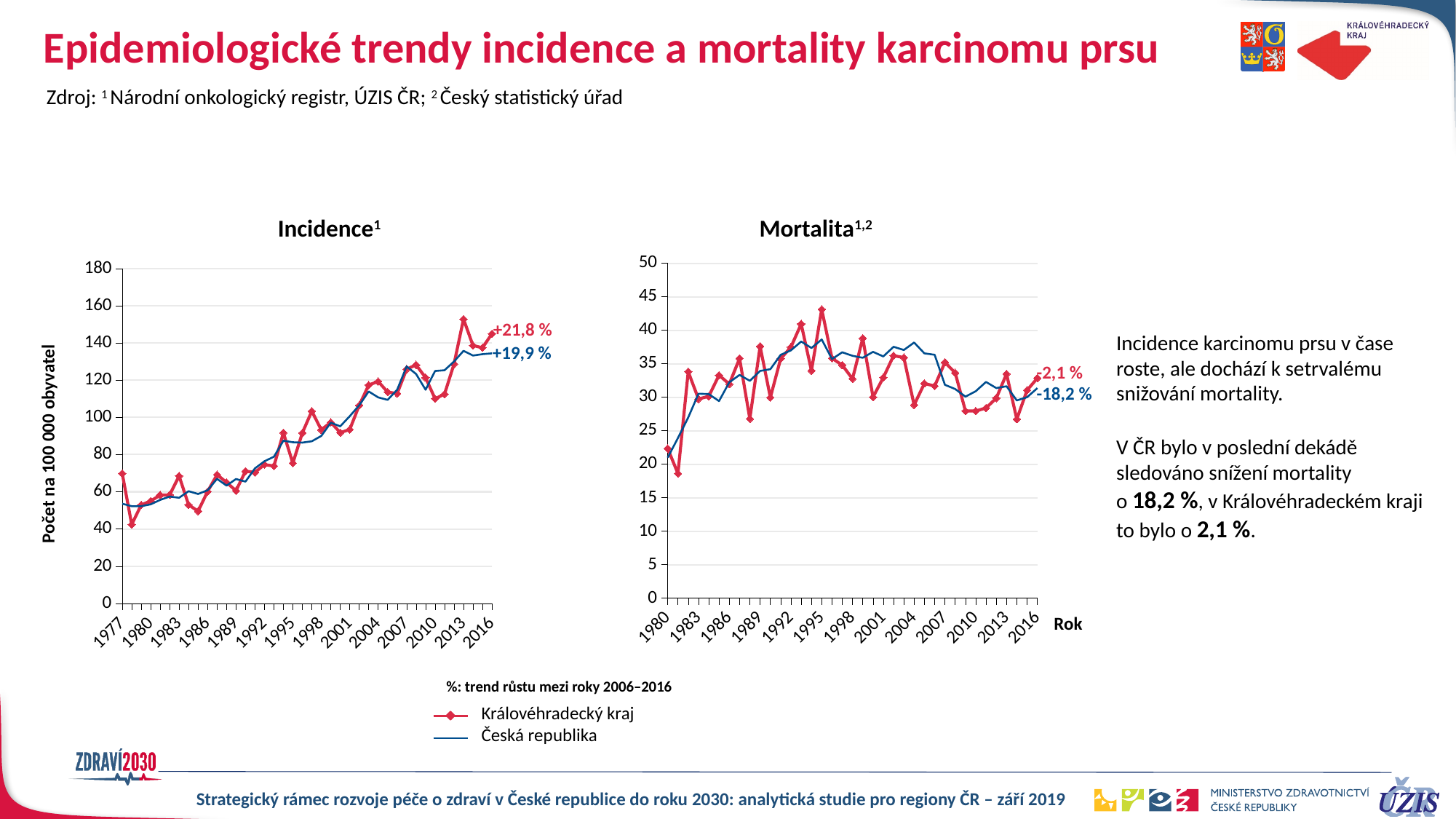
On the Mortalita chart, is the value for Královéhradecký kraj in 1981 greater or less than 20? less On the Mortalita chart, what trend between 2006 and 2016 is printed for Česká republika? -18,2 % On the Mortalita chart, do the values for Česká republika rise or fall from 2006 to 2016? fall What kind of chart is the Incidence chart? line chart On the Incidence chart, is the value for Královéhradecký kraj in 2013 greater or less than 140? greater On the Incidence chart, what growth trend between 2006 and 2016 is printed for Česká republika? +19,9 % Which series is drawn in red on the charts? Královéhradecký kraj On the Incidence chart, do the values for Česká republika generally rise or fall from 1977 to 2016? rise On the Mortalita chart, what trend between 2006 and 2016 is printed for Královéhradecký kraj? -2,1 % How many series does the legend list for the charts? 2 On the Mortalita chart, is the value for Královéhradecký kraj in 1995 greater or less than 40? greater On the Incidence chart, what growth trend between 2006 and 2016 is printed for Královéhradecký kraj? +21,8 %